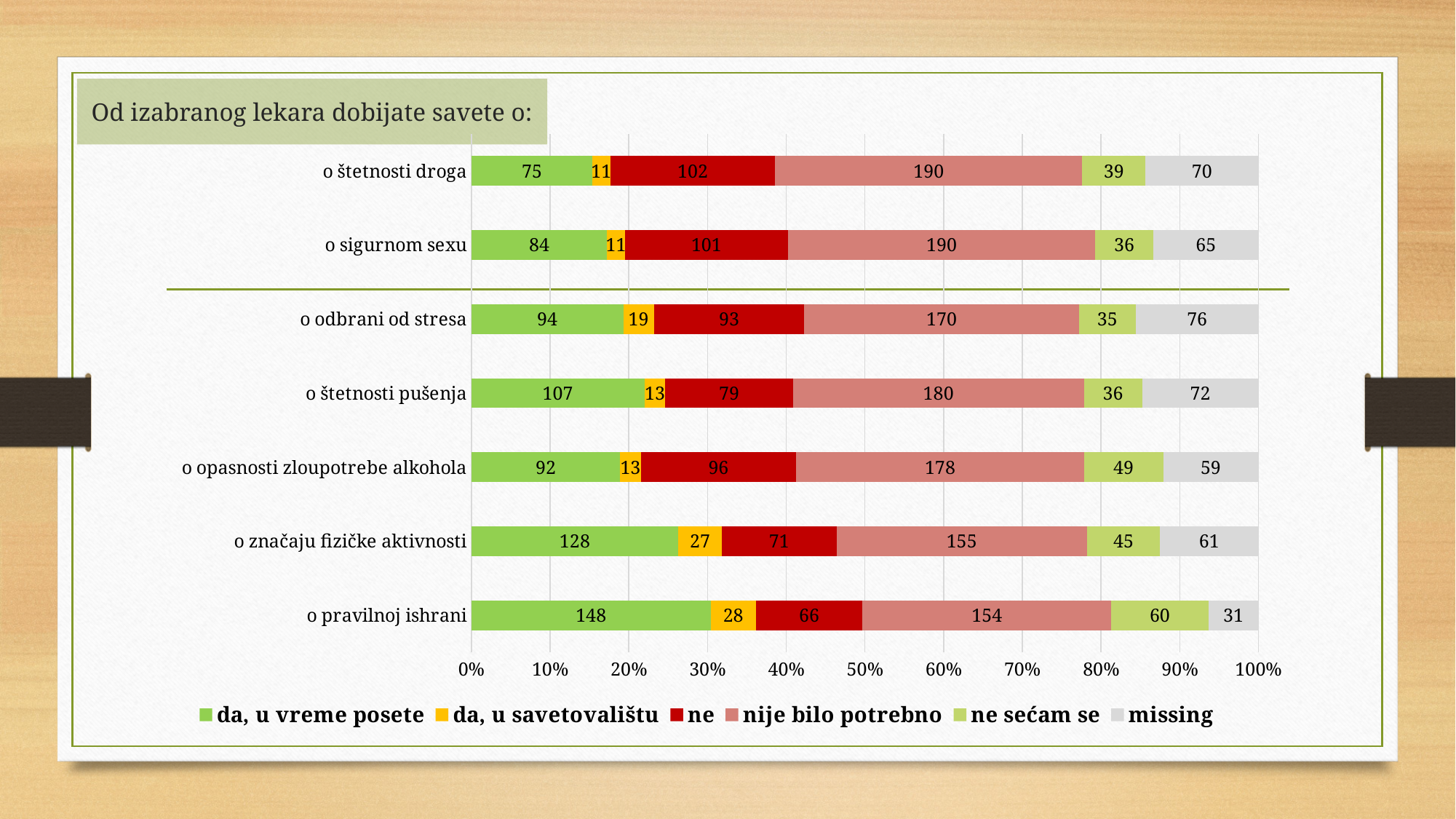
What is the total of all segments in the bar for "o sigurnom sexu"? 487 Which category has the lowest value for "ne"? o pravilnoj ishrani What is the value of "da, u vreme posete" for "o pravilnoj ishrani"? 148 What is the difference between the "ne" values for "o štetnosti droga" and "o pravilnoj ishrani"? 36 How many series does the legend list? 6 What is the value of "nije bilo potrebno" for "o štetnosti droga"? 190 What is the title of the chart? Od izabranog lekara dobijate savete o: Which is larger: the "da, u savetovalištu" value for "o značaju fizičke aktivnosti" or for "o odbrani od stresa"? o značaju fizičke aktivnosti How many categories are shown on the y axis? 7 What is the "missing" value for "o odbrani od stresa"? 76 Which category has the highest value for "da, u vreme posete"? o pravilnoj ishrani What kind of chart is shown? stacked bar chart